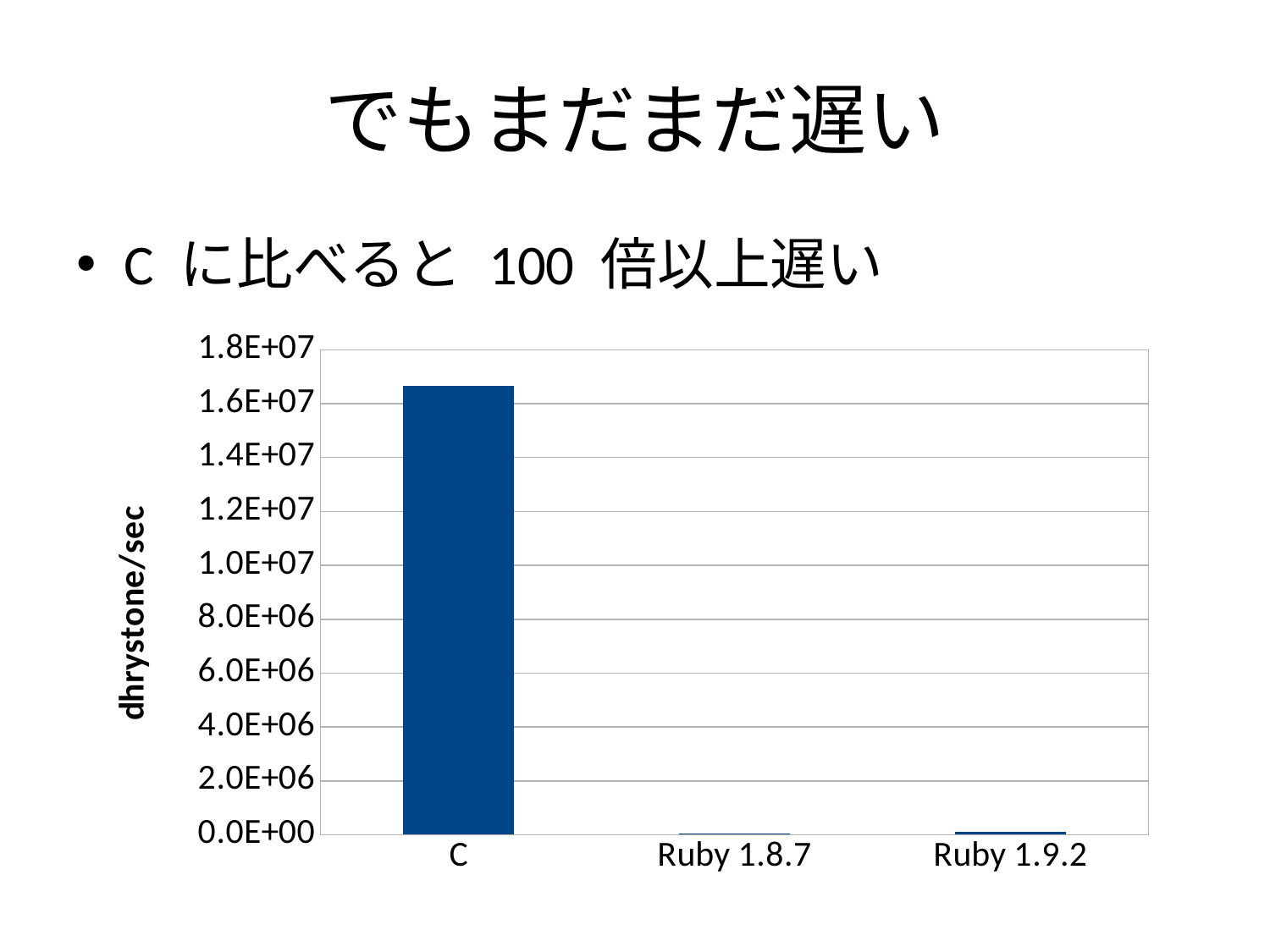
Is the value for C greater or less than 1.6E+07? greater What is the highest tick value shown on the vertical axis? 1.8E+07 Is the value for Ruby 1.9.2 greater or less than 2.0E+06? less What kind of chart is shown on the slide? bar chart Is the value for C greater or less than 1.8E+07? less What is the label on the vertical axis of the chart? dhrystone/sec Which is larger, the value for C or the value for Ruby 1.8.7? C How many categories are plotted on the x axis of the chart? 3 Which is larger, the value for C or the value for Ruby 1.9.2? C Which category has the highest value in the chart? C